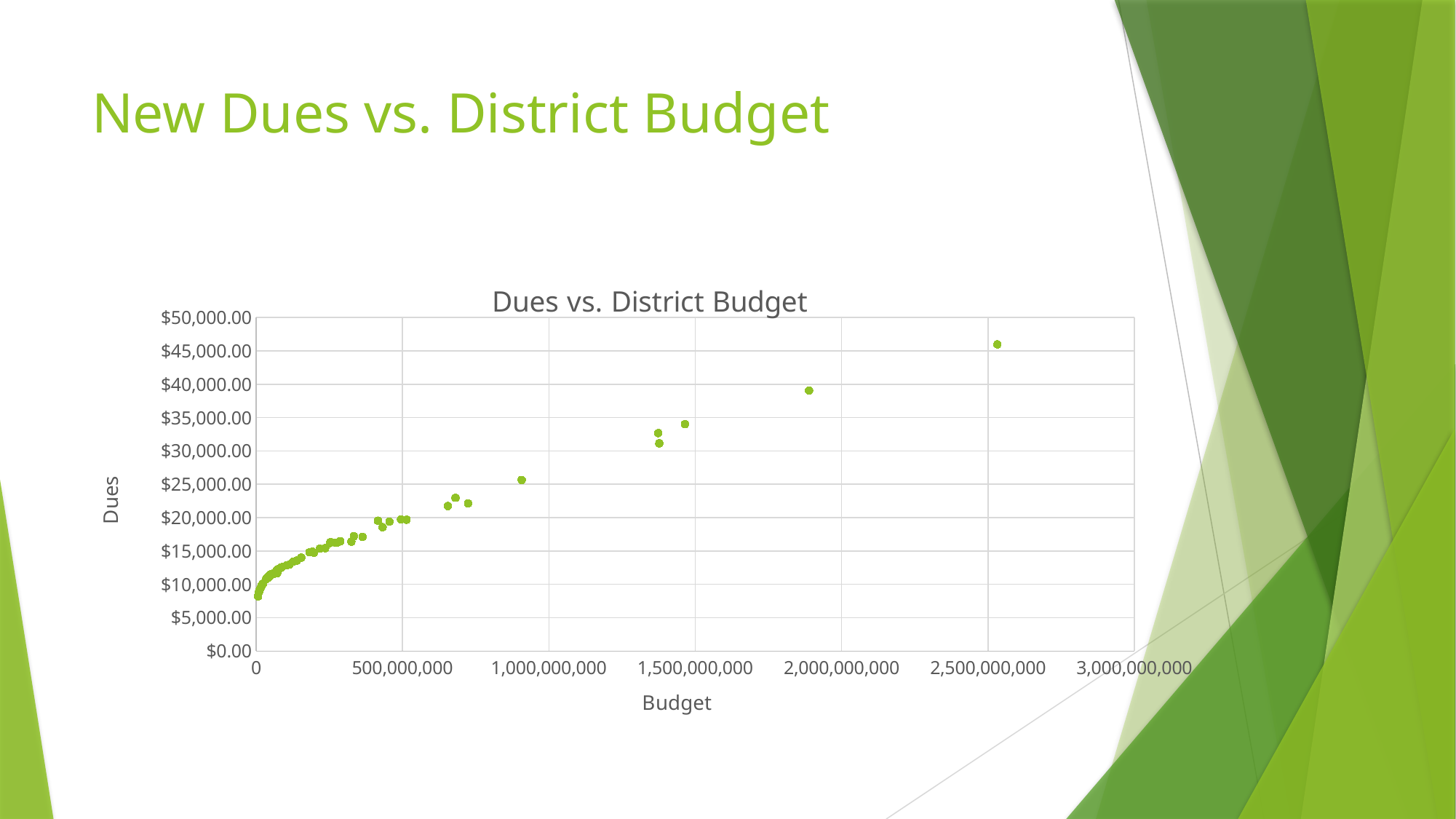
Is the dues value for the point with the largest budget greater or less than $40,000.00? greater What is the label of the vertical axis of the chart? Dues Which has higher dues: the point with a budget of about 2,500,000,000 or the point with a budget of about 1,900,000,000? the point with a budget of about 2,500,000,000 What is the title of the chart? Dues vs. District Budget Is the dues value for the point with a budget of about 900,000,000 greater or less than $20,000.00? greater What kind of chart is shown on the slide? scatter chart Does the point with the highest dues also have the largest budget? yes Is the dues value for the point with a budget of about 1,900,000,000 greater or less than $35,000.00? greater How many points have dues greater than $40,000.00? 1 How many points have a budget greater than 1,000,000,000? 5 As budget increases along the x axis, do the dues values rise or fall? rise